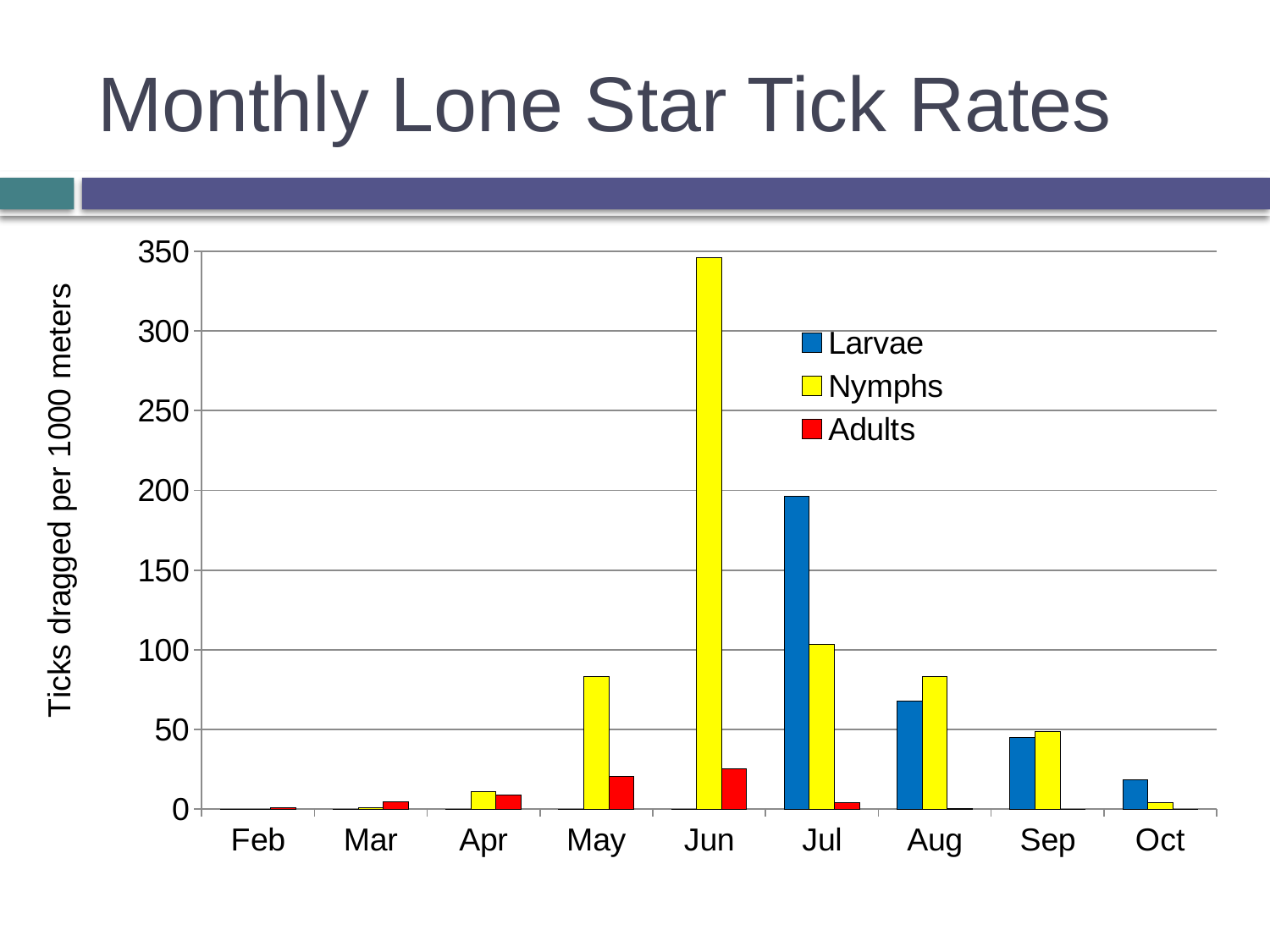
In Jul, which is larger, the Larvae value or the Nymphs value? Larvae In which month is the Nymphs value highest? Jun Is the Nymphs value for Jun greater or less than 300? greater How many series does the legend list? 3 In Aug, which is larger, the Larvae value or the Nymphs value? Nymphs Is the Nymphs value for Jul greater or less than 150? less Is the Larvae value for Jul greater or less than 150? greater In which month is the Larvae value highest? Jul What is the title of the y axis? Ticks dragged per 1000 meters What kind of chart is shown on the slide? bar chart How many months are shown on the x axis? 9 Do the Larvae values rise or fall from Jul to Oct? fall